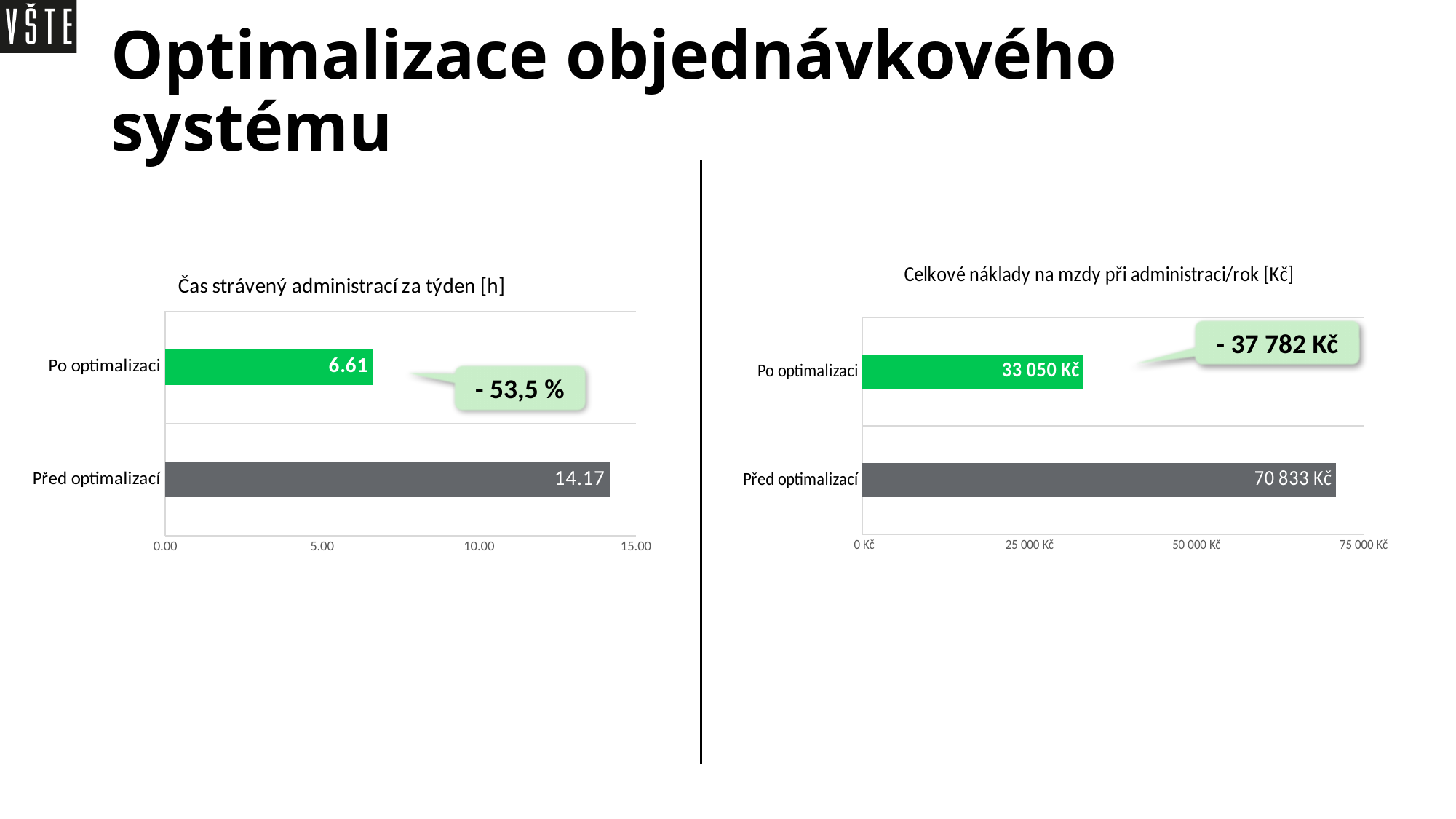
In the left chart (Čas strávený administrací za týden [h]), which category has the highest value? Před optimalizací In the left chart (Čas strávený administrací za týden [h]), what is the value for Před optimalizací? 14.17 In the right chart (Celkové náklady na mzdy při administraci/rok [Kč]), which category has the lowest value? Po optimalizaci How many categories does the left chart (Čas strávený administrací za týden [h]) show? 2 In the left chart (Čas strávený administrací za týden [h]), what is the difference between Před optimalizací and Po optimalizaci? 7.56 In the right chart (Celkové náklady na mzdy při administraci/rok [Kč]), is the value for Před optimalizací larger or smaller than the value for Po optimalizaci? larger What type of chart is the right chart (Celkové náklady na mzdy při administraci/rok [Kč])? bar chart What percentage change does the callout in the left chart (Čas strávený administrací za týden [h]) show? - 53,5 % In the left chart (Čas strávený administrací za týden [h]), what is the value for Po optimalizaci? 6.61 In the right chart (Celkové náklady na mzdy při administraci/rok [Kč]), what is the value for Před optimalizací? 70 833 Kč In the right chart (Celkové náklady na mzdy při administraci/rok [Kč]), is the value for Po optimalizaci greater or less than 50 000 Kč? less In the right chart (Celkové náklady na mzdy při administraci/rok [Kč]), what is the value for Po optimalizaci? 33 050 Kč